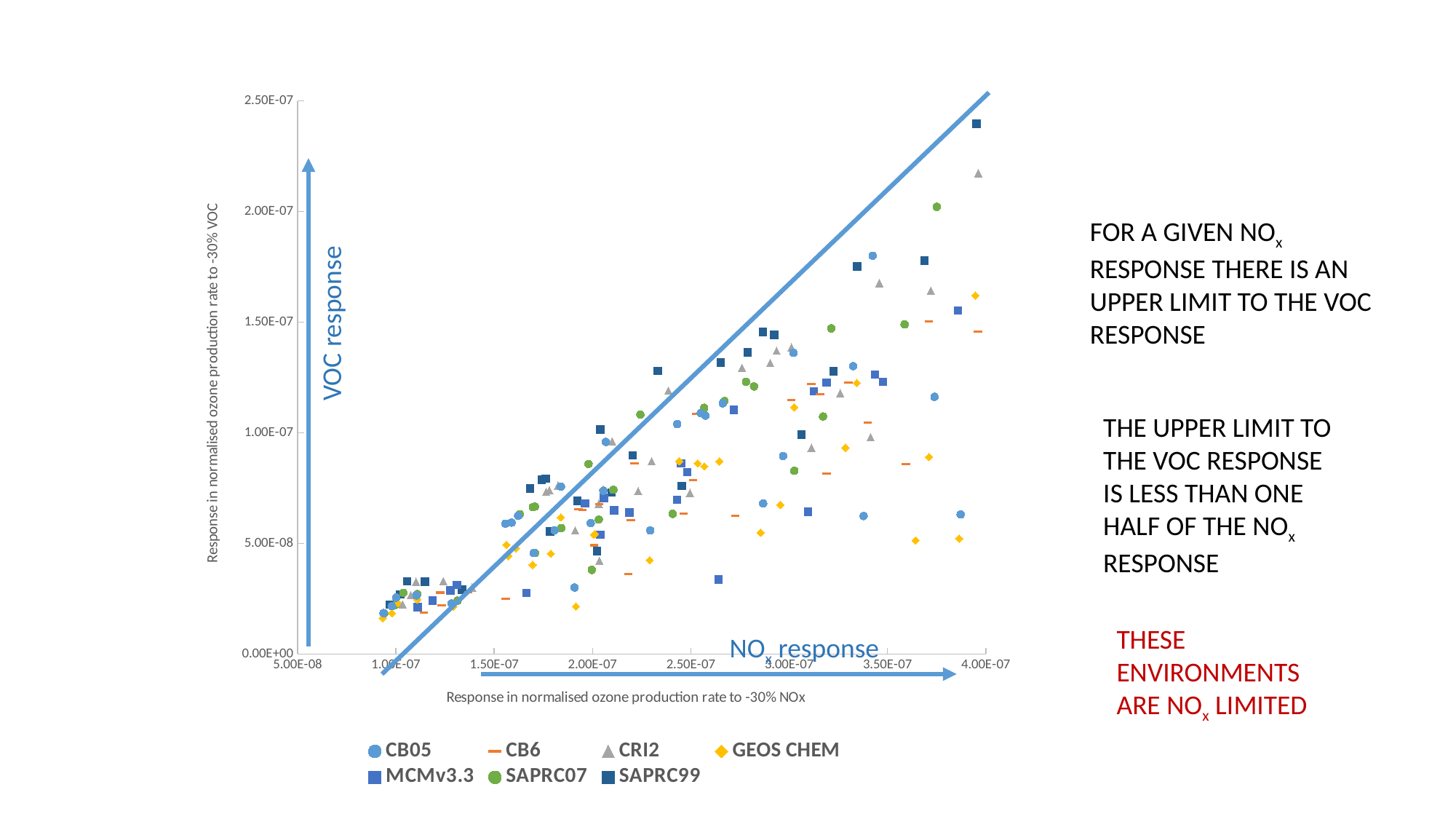
Which series is plotted with yellow diamond markers? GEOS CHEM What is the highest tick value shown on the vertical axis? 2.50E-07 What is the title of the vertical axis? Response in normalised ozone production rate to -30% VOC Is the highest plotted VOC response value greater or less than 2.00E-07? greater What kind of chart is shown on the slide? scatter chart How many series does the legend list? 7 Which series contains the point with the highest VOC response on the chart? SAPRC99 Do the VOC response values generally rise or fall as the NOx response increases along the x axis? rise